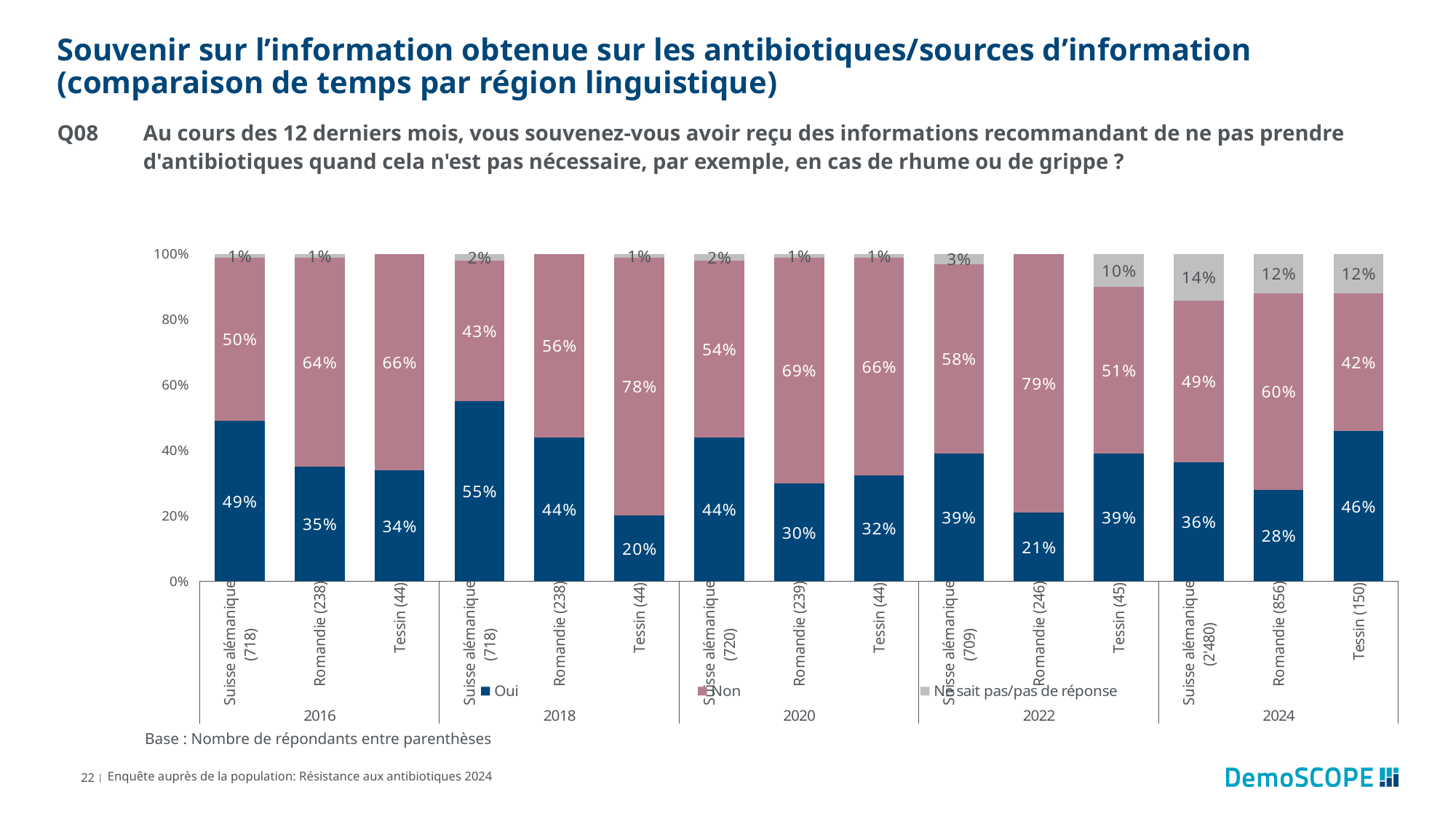
Which is larger: the 'Oui' value for Romandie (238) in 2016 or the 'Oui' value for Romandie (856) in 2024? Romandie (238) in 2016 What is the difference between the 'Non' value for Tessin (44) in 2018 and the 'Non' value for Tessin (150) in 2024? 36% How does the 'Oui' value for Suisse alémanique change from 2018 to 2024? It falls What is the 'Non' value for Romandie (246) in 2022? 79% Which bar has the lowest 'Oui' value? Tessin (44) in 2018 How many bars are plotted in the chart? 15 How many series does the legend list? 3 What is the 'Ne sait pas/pas de réponse' value for Suisse alémanique (2'480) in 2024? 14% Which bar has the highest 'Oui' value? Suisse alémanique (718) in 2018 Which colour represents the 'Oui' series in the chart? dark blue What kind of chart is shown on the slide? stacked bar chart What is the 'Oui' value for Tessin (150) in 2024? 46%